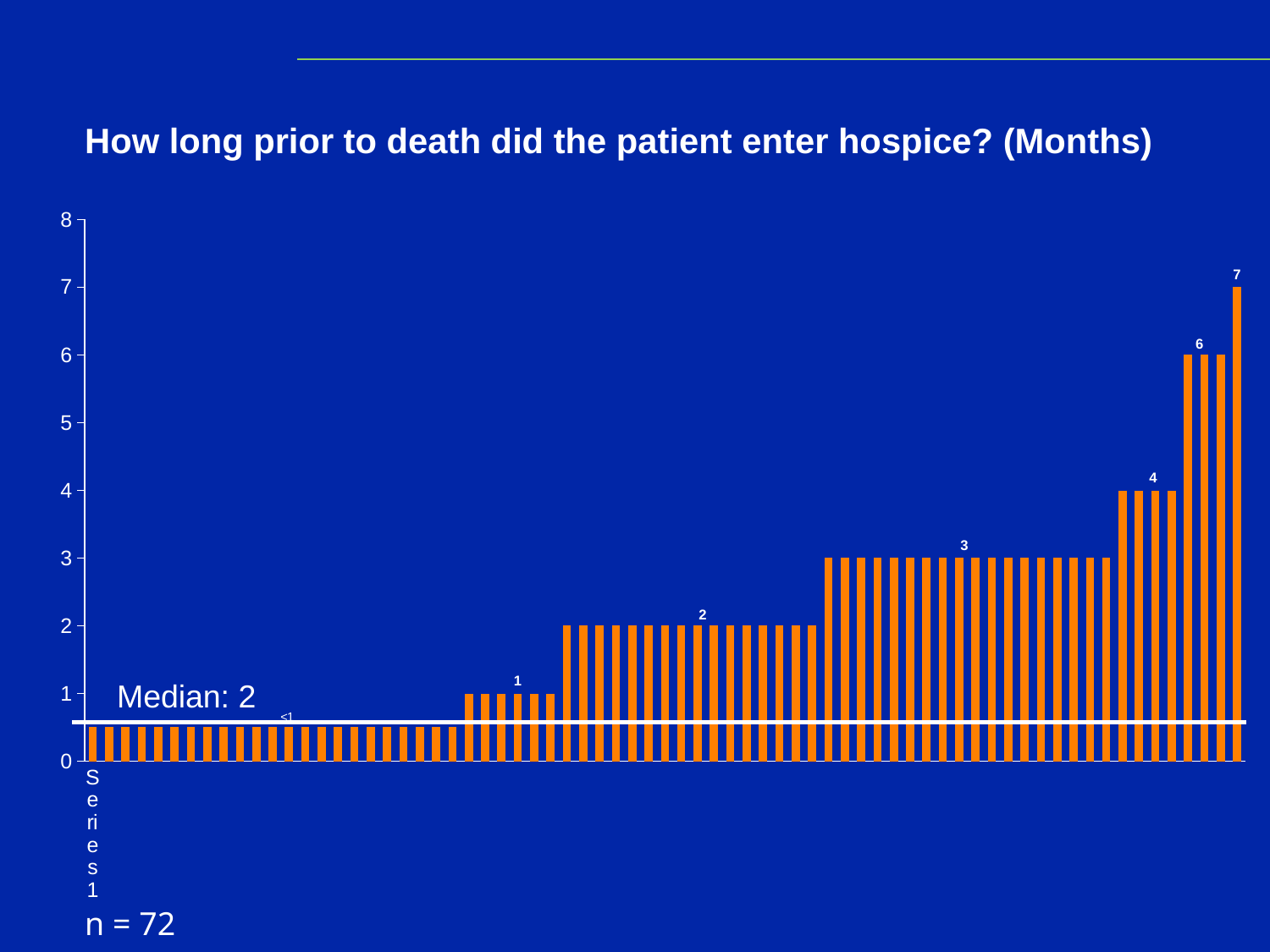
Is the value of the tallest bar greater or less than 6? greater What median value is annotated on the chart? Median: 2 What is the highest tick value shown on the vertical axis? 8 Which is larger: the bars labelled 4 or the bars labelled 3? the bars labelled 4 Are the bars labelled 2 greater or less than 3 on the vertical axis? less Do the bar values rise or fall from left to right across the chart? rise What is the difference between the tallest bar (7) and the bars labelled 6? 1 How many patients (n) does the chart represent, according to the slide? 72 What is the difference between the bars labelled 4 and the bars labelled 1? 3 What kind of chart is shown on the slide? bar chart What is the value labelled on the shortest bars in the chart? <1 What is the value of the tallest bar in the chart? 7